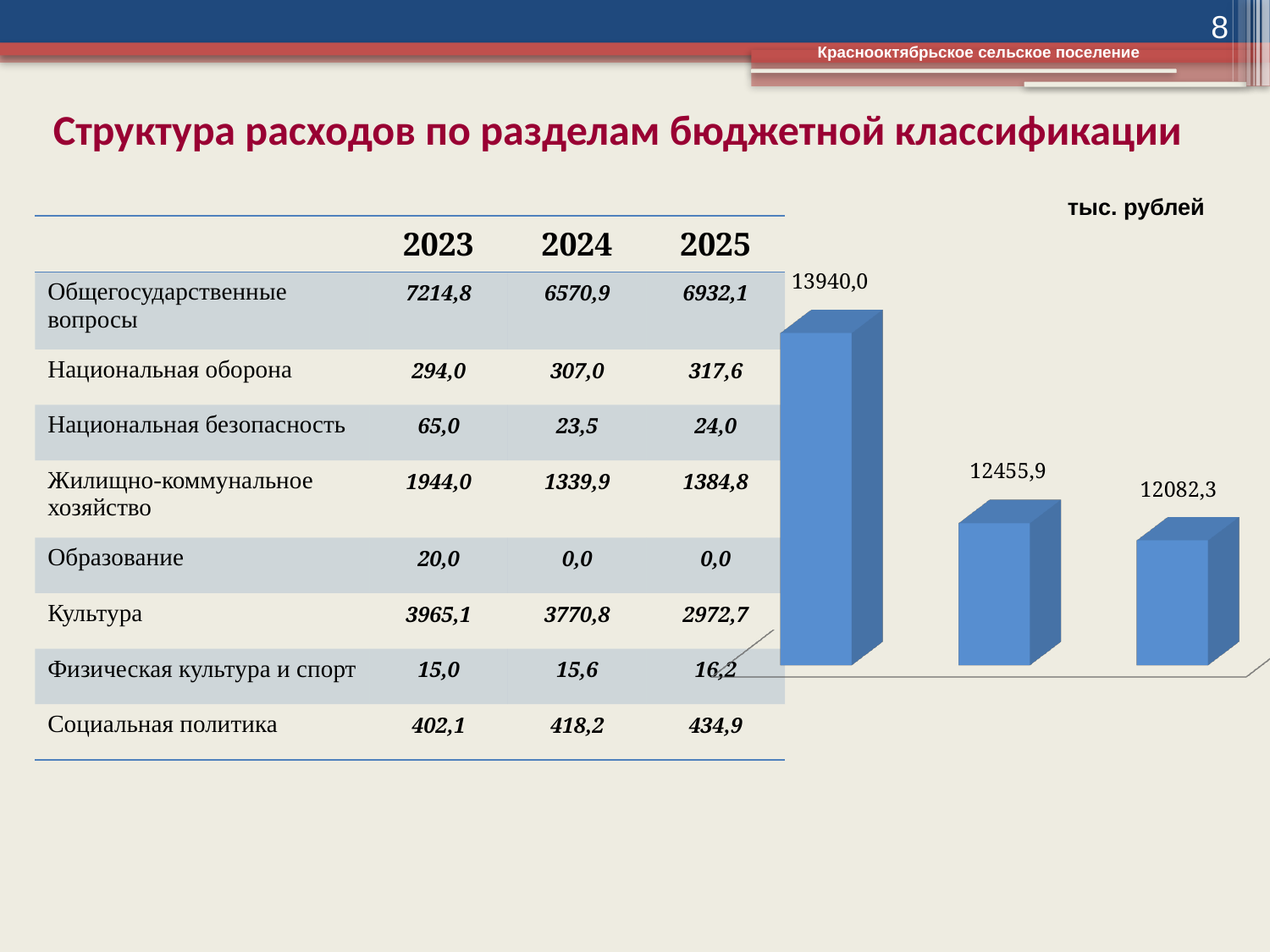
In what unit are the chart values expressed, according to the label above the chart? тыс. рублей Which bar in the chart has the highest value? the first (leftmost) bar, 13940,0 What is the difference between the middle bar (12455,9) and the last bar (12082,3)? 373,6 What is the value shown on the middle bar of the chart? 12455,9 How many bars does the chart show? 3 What is the value shown on the last (rightmost) bar of the chart? 12082,3 Do the bar values rise or fall from left to right across the chart? fall What kind of chart is shown on the slide? bar chart Which bar in the chart has the lowest value? the last (rightmost) bar, 12082,3 What is the value shown on the first (leftmost) bar of the chart? 13940,0 Which is larger: the value of the middle bar or the value of the rightmost bar? the middle bar (12455,9) What is the difference between the first bar (13940,0) and the middle bar (12455,9)? 1484,1